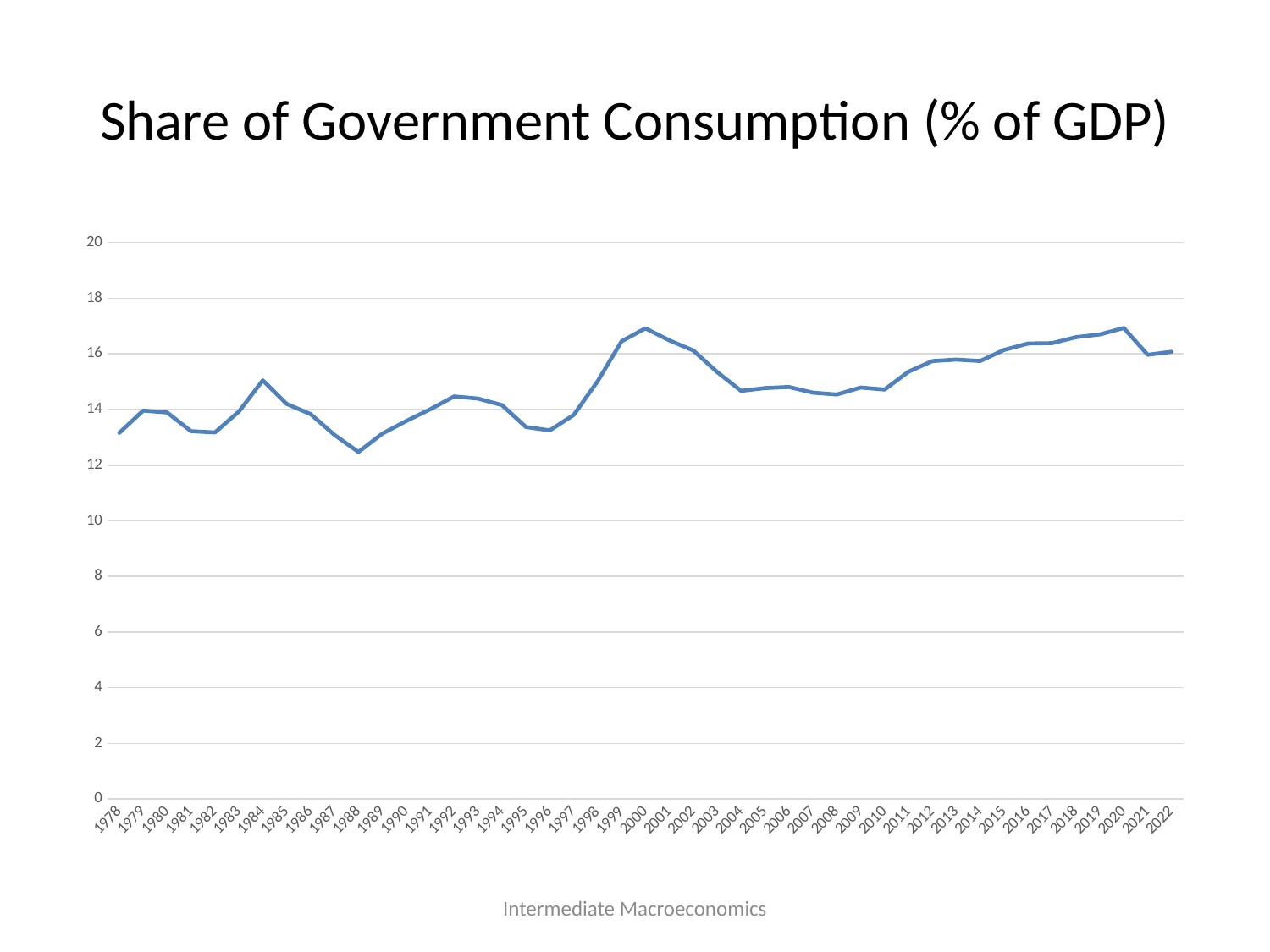
What is the title of the chart? Share of Government Consumption (% of GDP) Which year has the lowest share of government consumption? 1988 How many years are plotted along the x axis? 45 Is the value for 2000 greater or less than 16? greater What kind of chart is shown on the slide? line chart Is the value for 1978 greater or less than 12? greater Overall, does the share of government consumption rise or fall from 1978 to 2022? rise Is the value for 1984 greater or less than 14? greater Which year has the larger value, 2000 or 2004? 2000 Which year has the larger value, 1984 or 1988? 1984